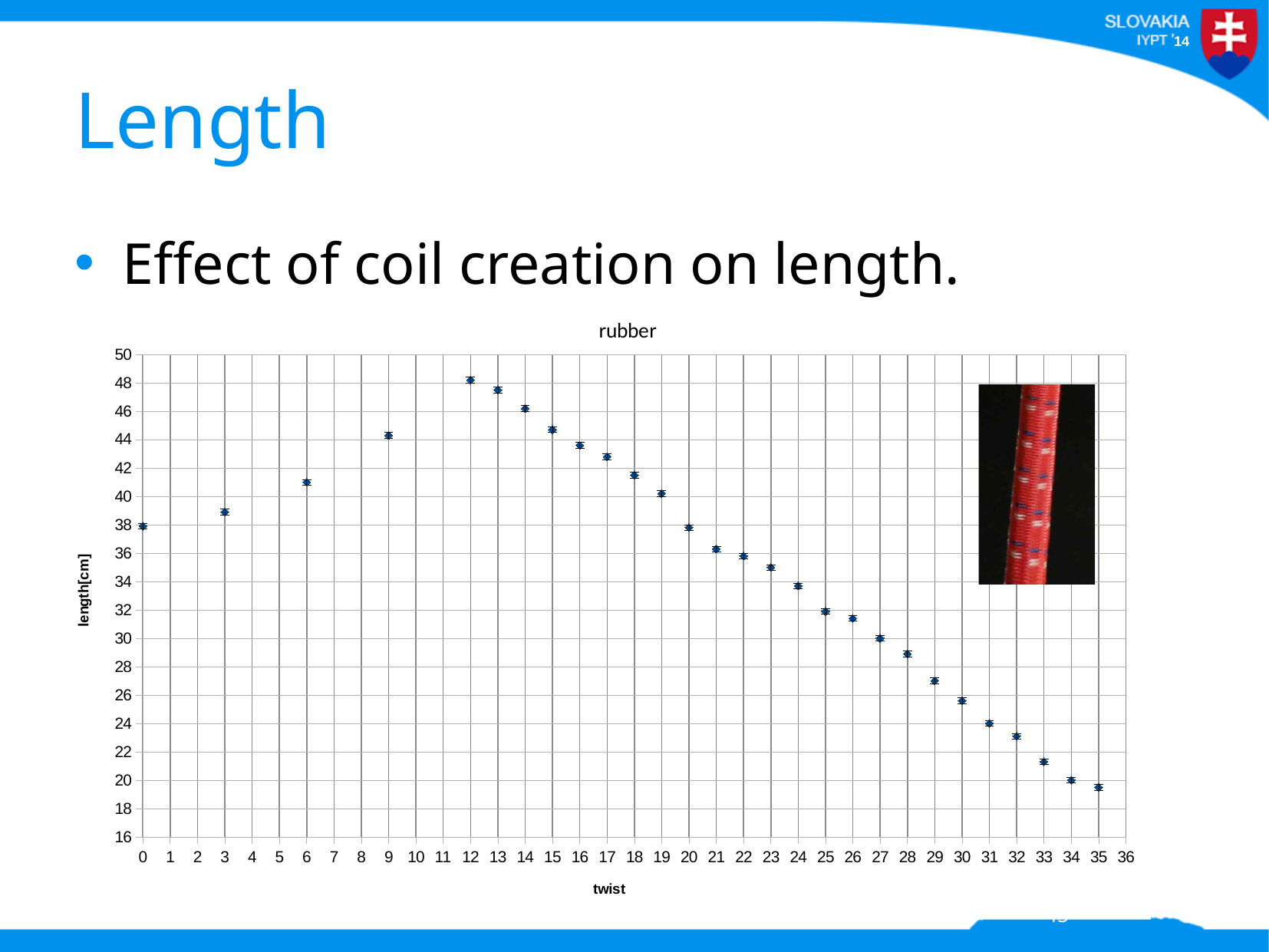
How does the length change as twist increases from 12 to 35? it falls Is the length at twist 34 greater or less than 22? less At which twist value is the length highest? 12 Which has the larger length, twist 20 or twist 28? twist 20 Which has the larger length, twist 3 or twist 6? twist 6 What is the label of the y axis of the chart? length[cm] Is the length at twist 6 greater or less than 40? greater Is the length at twist 30 greater or less than 24? greater At which twist value is the length lowest? 35 What is the title of the chart? rubber What kind of chart is shown on the slide? scatter plot